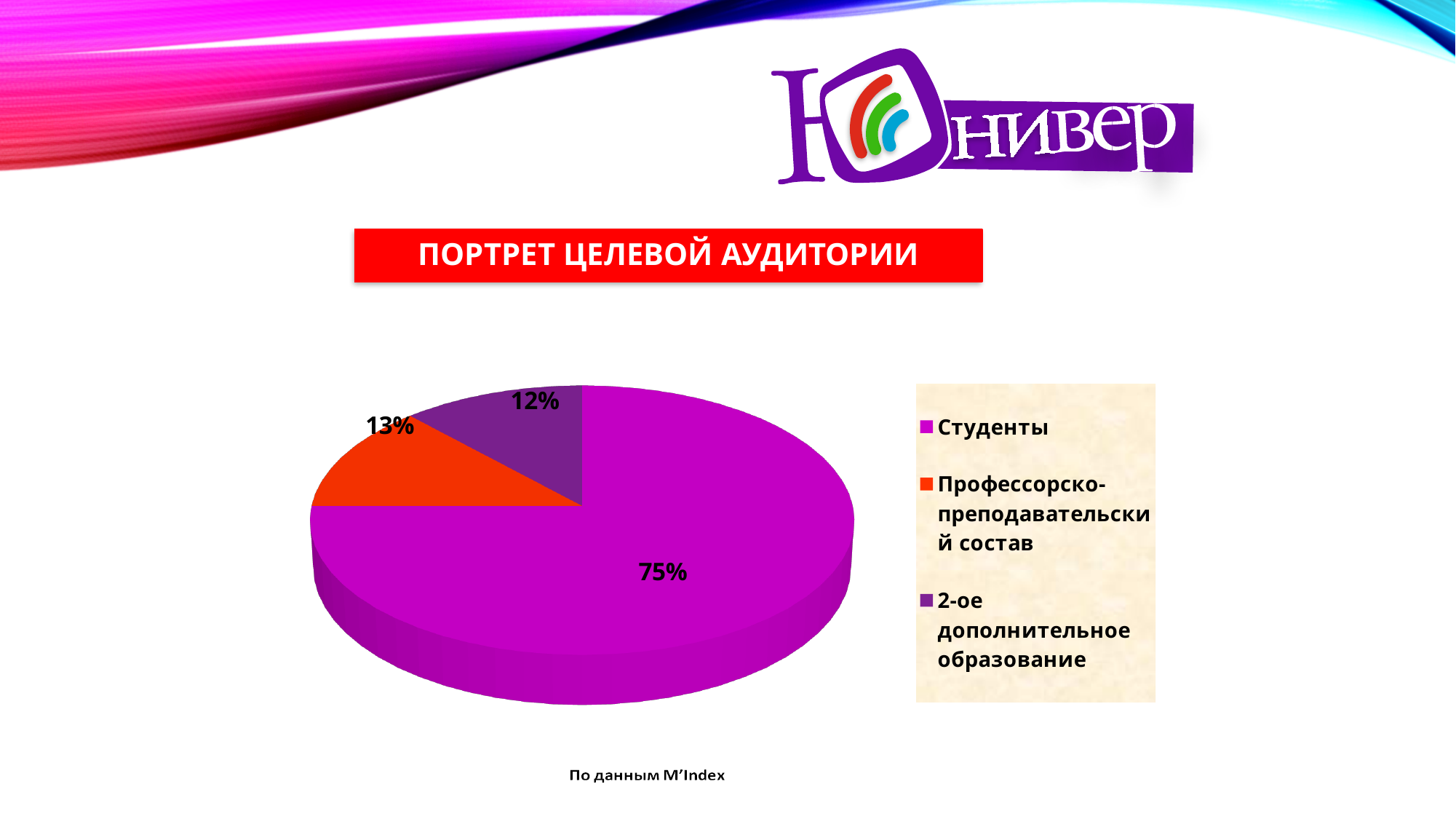
Which category has the smallest slice of the pie chart? 2-ое дополнительное образование What colour is the Студенты slice in the pie chart? Magenta What share of the pie chart is labelled for Студенты? 75% Which slice is larger: Профессорско-преподавательский состав or 2-ое дополнительное образование? Профессорско-преподавательский состав Which category has the largest slice of the pie chart? Студенты What kind of chart is shown on the slide? Pie chart What data source is cited below the pie chart? По данным M'Index What is the difference in percentage points between the Студенты slice and the Профессорско-преподавательский состав slice? 62 What share of the pie chart is labelled for 2-ое дополнительное образование? 12% What share of the pie chart is labelled for Профессорско-преподавательский состав? 13% How many entries does the legend list? 3 How many slices does the pie chart have? 3